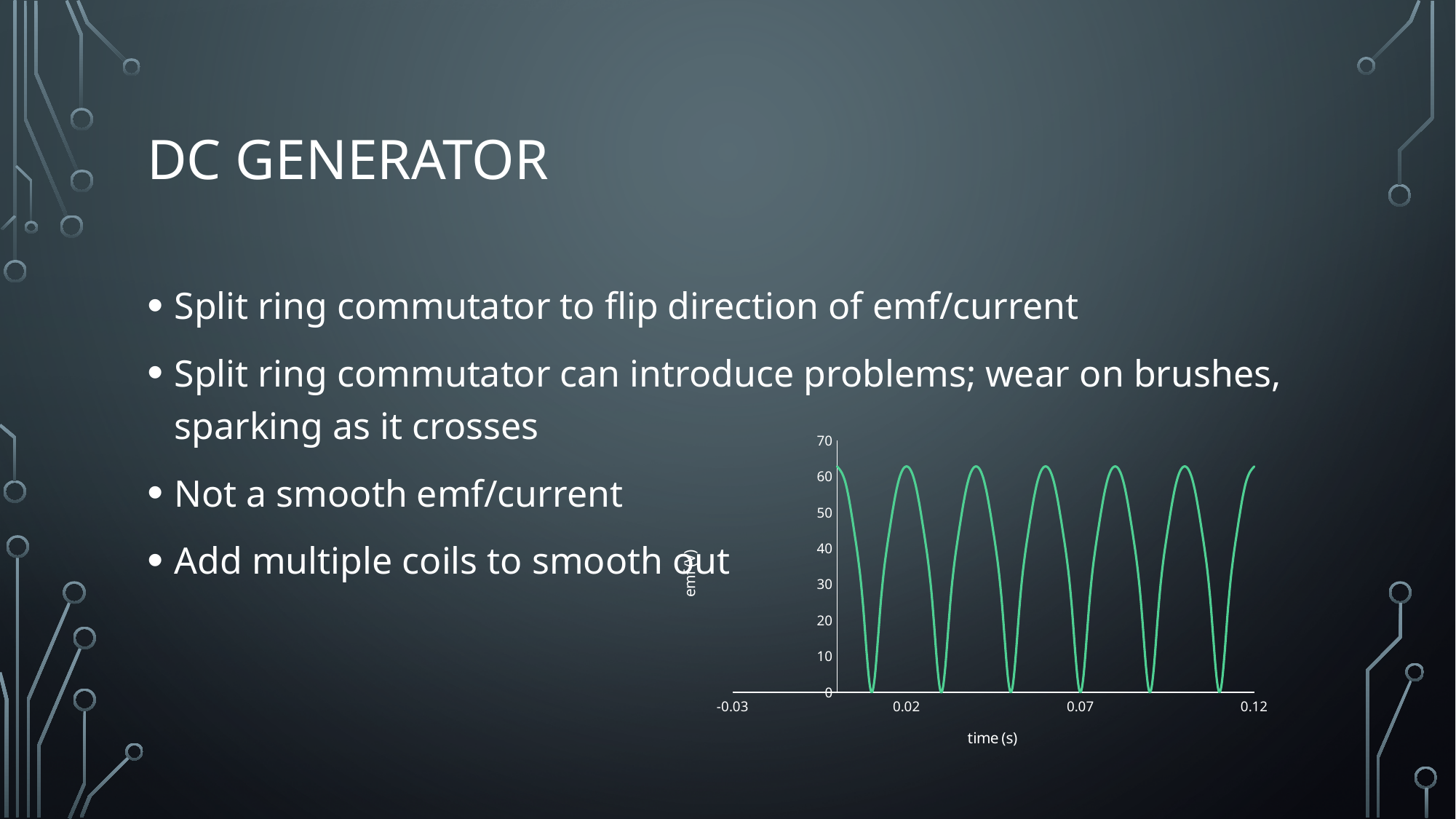
What is the label of the y axis of the chart? emf (V) What kind of chart is shown on the slide? line chart How many times does the emf curve touch zero within the plotted range? 6 What is the label of the x axis of the chart? time (s) What is the spacing between consecutive tick labels on the y axis? 10 What is the highest tick value shown on the y axis of the chart? 70 Does the emf curve ever drop below 0 on the chart? No Are the peak values of the emf curve greater or less than 50? greater Does the emf value rise steadily, fall steadily, or oscillate along the time axis? oscillate Are the minimum values of the emf curve greater or less than 10? less What is the highest tick value shown on the x axis of the chart? 0.12 What is the lowest tick value shown on the x axis of the chart? -0.03